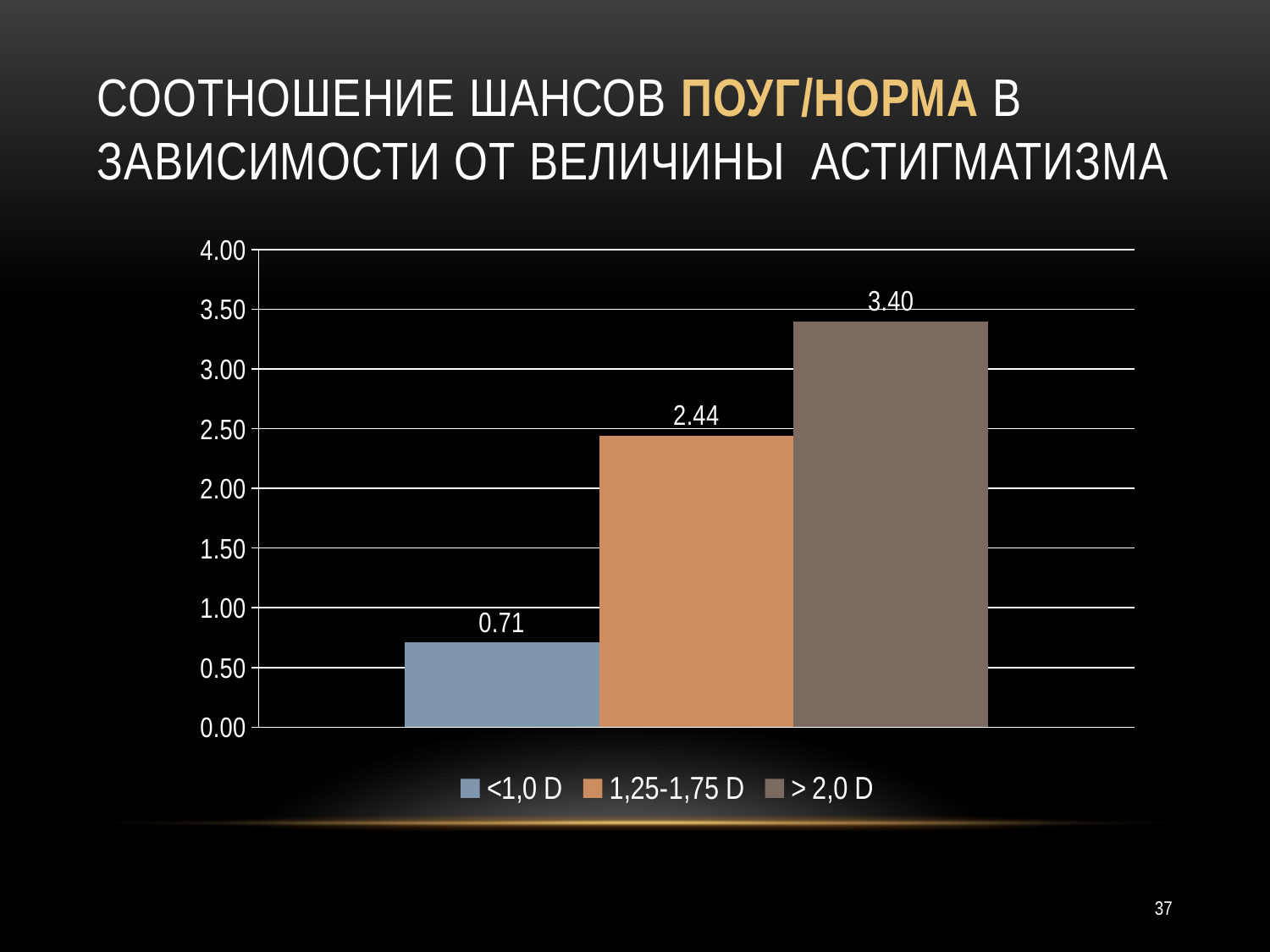
How many bars are shown in the chart? 3 What is the odds ratio value for the <1,0 D group? 0.71 What is the odds ratio value for the 1,25-1,75 D group? 2.44 Which astigmatism group has the highest odds ratio? > 2,0 D What is the difference between the odds ratio for 1,25-1,75 D and for <1,0 D? 1.73 Do the values rise or fall as the astigmatism magnitude increases from left to right? rise What kind of chart is shown on the slide? bar chart Which astigmatism group has the lowest odds ratio? <1,0 D Is the value for <1,0 D greater or less than 1.00? less What is the difference between the odds ratio for > 2,0 D and for 1,25-1,75 D? 0.96 Which is larger, the odds ratio for <1,0 D or for 1,25-1,75 D? 1,25-1,75 D What is the odds ratio value for the > 2,0 D group? 3.40